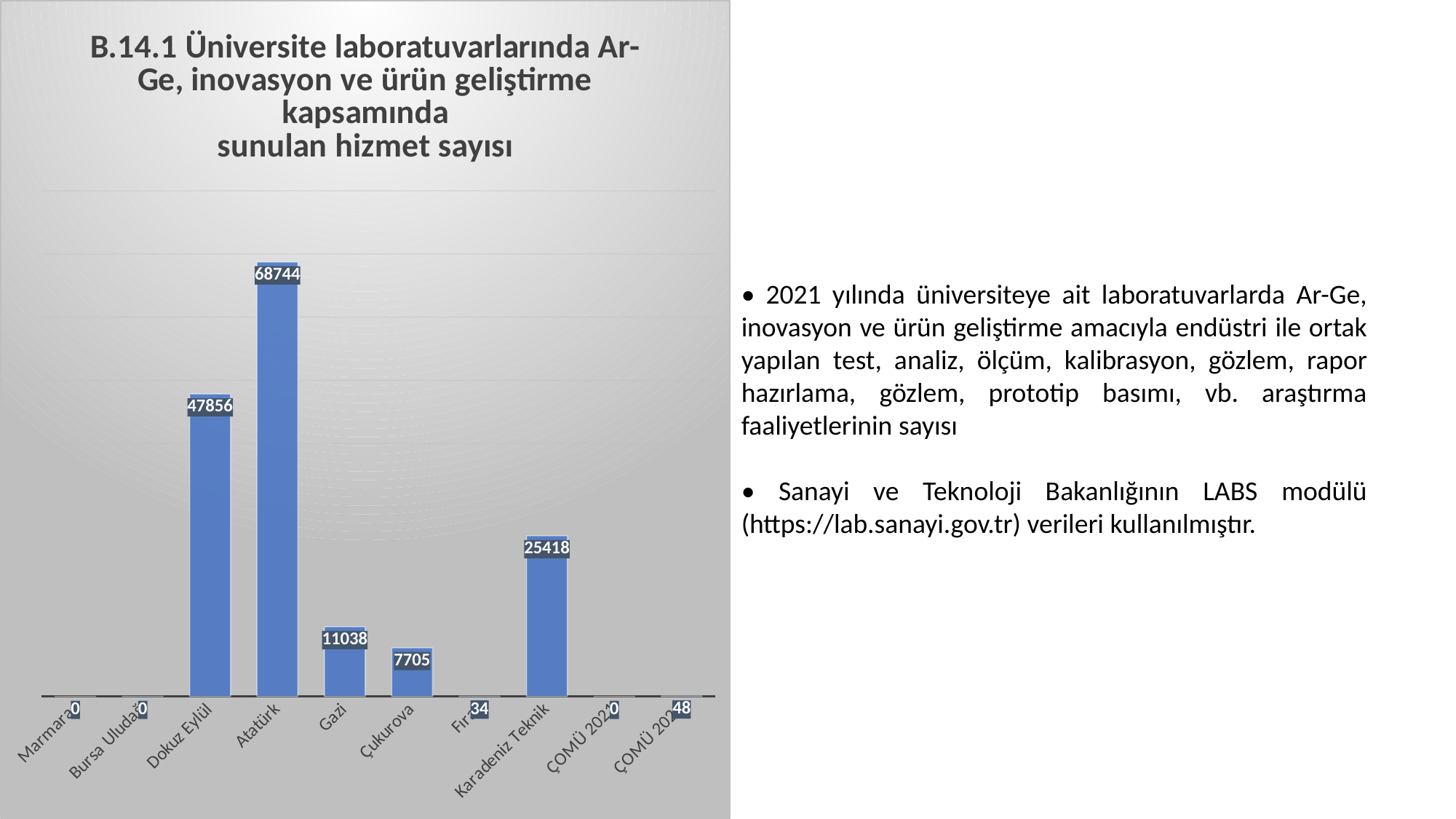
What is the value for Karadeniz Teknik? 25418 What is the value for Dokuz Eylül? 47856 How many universities (categories) are shown on the x axis? 10 What is the difference between the values for Karadeniz Teknik and Gazi? 14380 What is the value for Atatürk? 68744 What is the value for Marmara? 0 What kind of chart is shown on the slide? bar chart Which is larger, the value for Gazi or the value for Çukurova? Gazi Which university has the highest number of services? Atatürk What is the value for Çukurova? 7705 What is the value for Gazi? 11038 What is the difference between the values for Atatürk and Dokuz Eylül? 20888